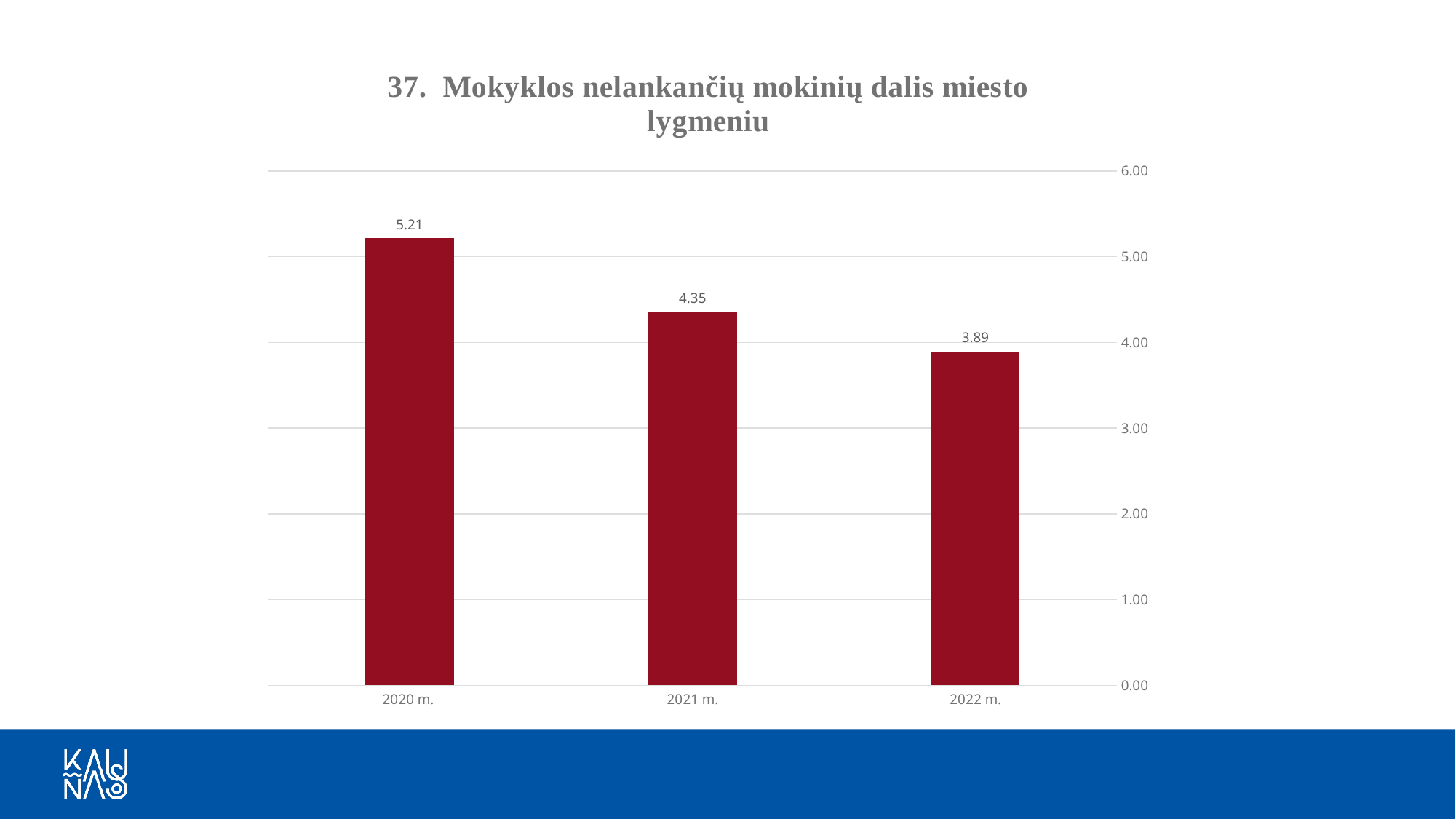
What is the value for 2022 m.? 3.89 What kind of chart is shown on the slide? bar chart Is the value for 2021 m. greater or less than 4.00? greater What is the difference between the values for 2020 m. and 2022 m.? 1.32 Which year has the lowest value? 2022 m. How many years are shown on the chart? 3 What is the difference between the values for 2020 m. and 2021 m.? 0.86 Which year has the highest value? 2020 m. What is the value for 2021 m.? 4.35 Which is larger, the value for 2021 m. or the value for 2022 m.? 2021 m. What is the value for 2020 m.? 5.21 Do the values rise or fall from 2020 m. to 2022 m.? fall